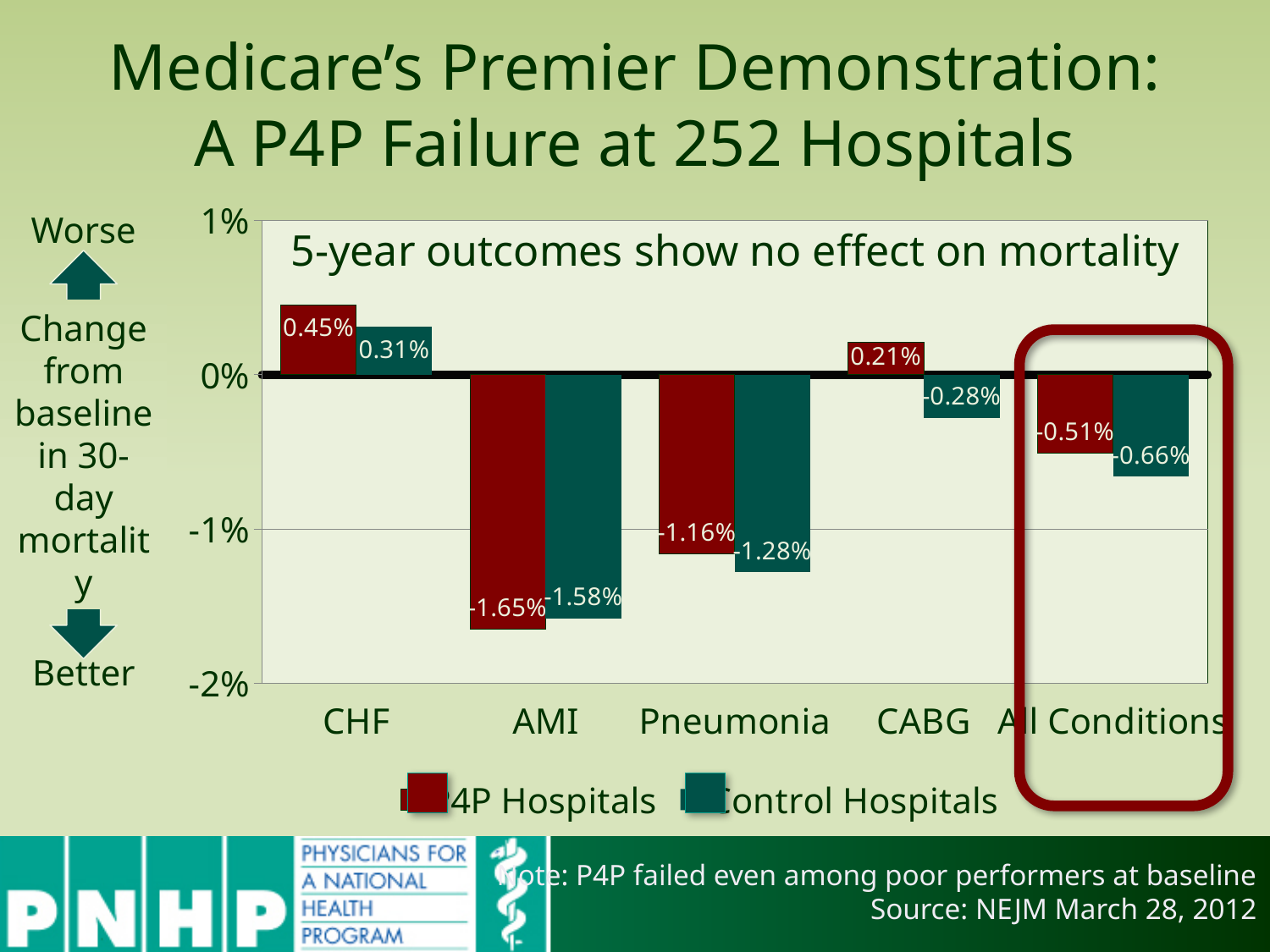
What is the value for P4P Hospitals in the All Conditions category? -0.51% How many categories are shown on the x axis? 5 Which category has the highest value for Control Hospitals? CHF Which category has the lowest value for P4P Hospitals? AMI What kind of chart is shown on the slide? Bar chart What is the value for P4P Hospitals in the CHF category? 0.45% What is the title shown inside the chart area? 5-year outcomes show no effect on mortality What is the value for Control Hospitals in the AMI category? -1.58% What is the difference between the P4P Hospitals and Control Hospitals values for Pneumonia? 0.12% How many series does the legend list? 2 What is the value for Control Hospitals in the CABG category? -0.28% For CABG, which series has the larger value, P4P Hospitals or Control Hospitals? P4P Hospitals